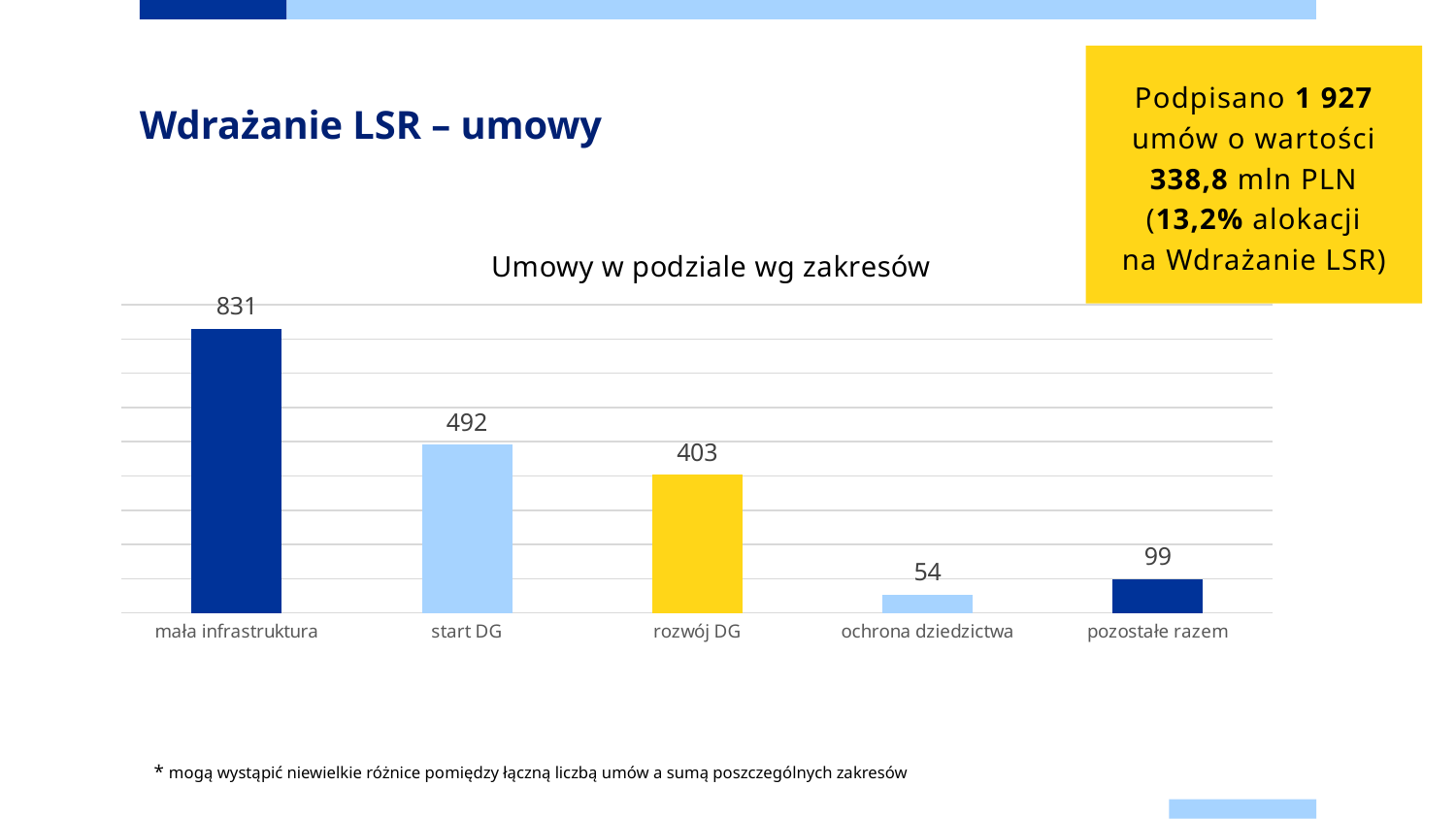
What is the value for rozwój DG? 403 Which is larger, the value for start DG or the value for rozwój DG? start DG Which category has the highest value? mała infrastruktura What is the difference between the values for mała infrastruktura and start DG? 339 What is the value for mała infrastruktura? 831 What is the title of the chart? Umowy w podziale wg zakresów How many categories are shown in the chart? 5 What is the value for pozostałe razem? 99 What kind of chart is shown on the slide? bar chart What is the value for start DG? 492 What is the value for ochrona dziedzictwa? 54 Which category has the lowest value? ochrona dziedzictwa